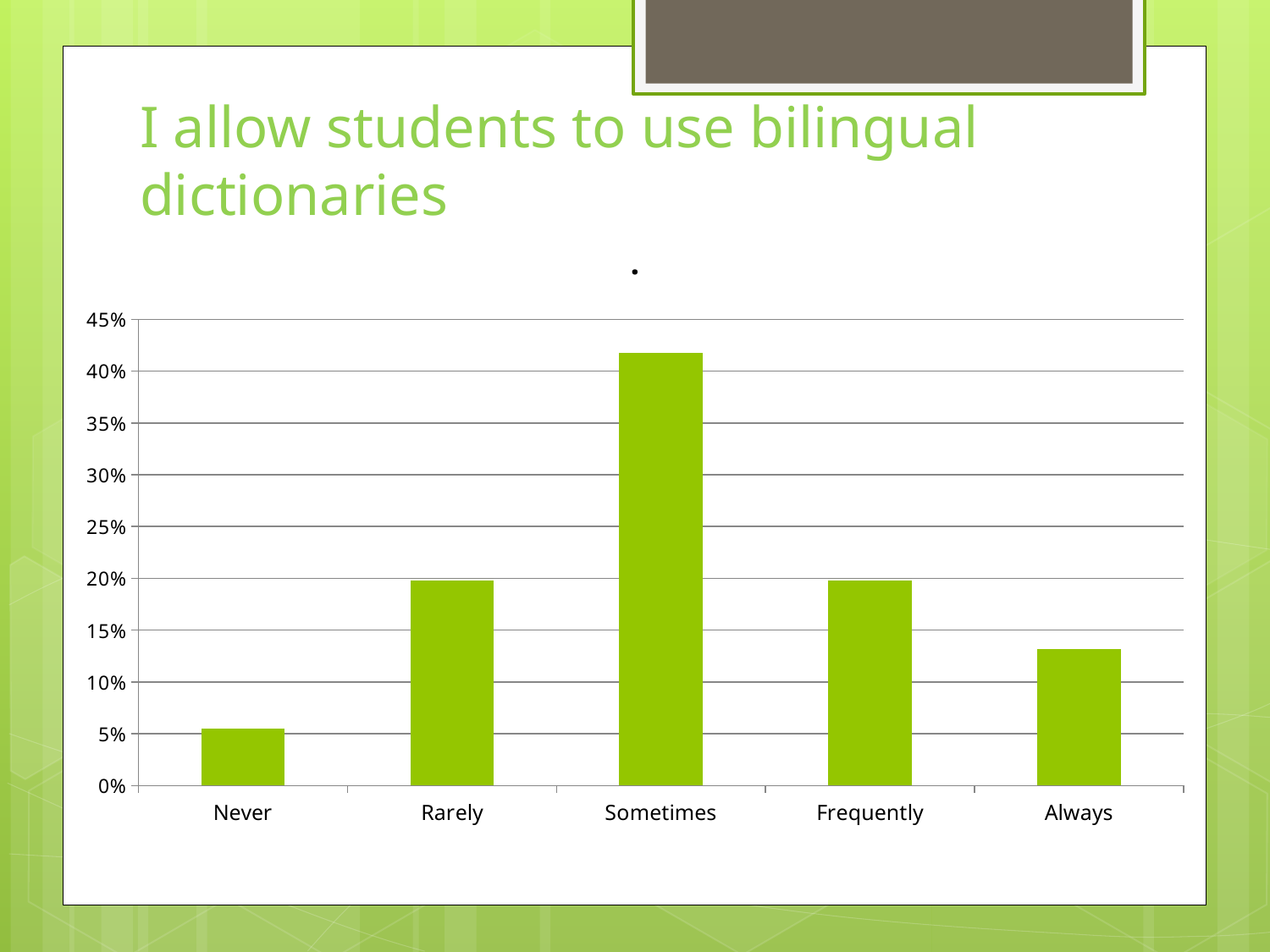
What kind of chart is shown on the slide? bar chart Which category has the highest value in the chart? Sometimes Which category has the lowest value in the chart? Never Which is larger, the value for Never or the value for Always? Always Is the value for Sometimes greater or less than 40%? greater Is the value for Always greater or less than 10%? greater What is the title of the slide containing the chart? I allow students to use bilingual dictionaries Which is larger, the value for Sometimes or the value for Always? Sometimes Is the value for Never greater or less than 10%? less How many categories are shown on the x axis of the chart? 5